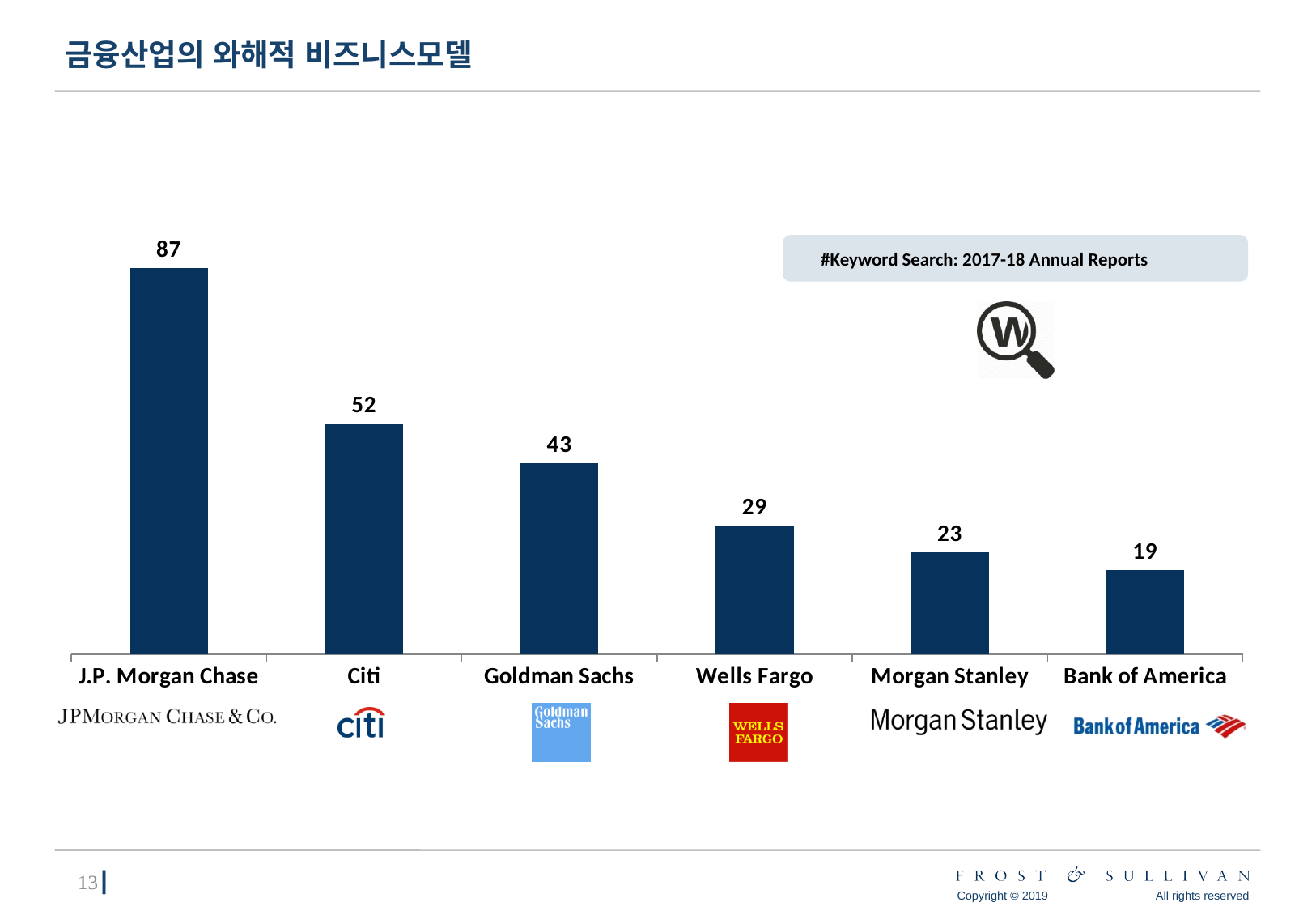
Which bank has the highest value? J.P. Morgan Chase Which bank has the lowest value? Bank of America What kind of chart is shown on the slide? bar chart Do the values rise or fall from left to right across the chart? fall What is the value for J.P. Morgan Chase? 87 What is the difference between the values for Citi and Wells Fargo? 23 How many banks are shown in the chart? 6 What is the value for Morgan Stanley? 23 Which is larger, the value for Goldman Sachs or the value for Morgan Stanley? Goldman Sachs What is the difference between the values for J.P. Morgan Chase and Bank of America? 68 What is the value for Goldman Sachs? 43 What does the text box on the chart say the keyword search covers? 2017-18 Annual Reports